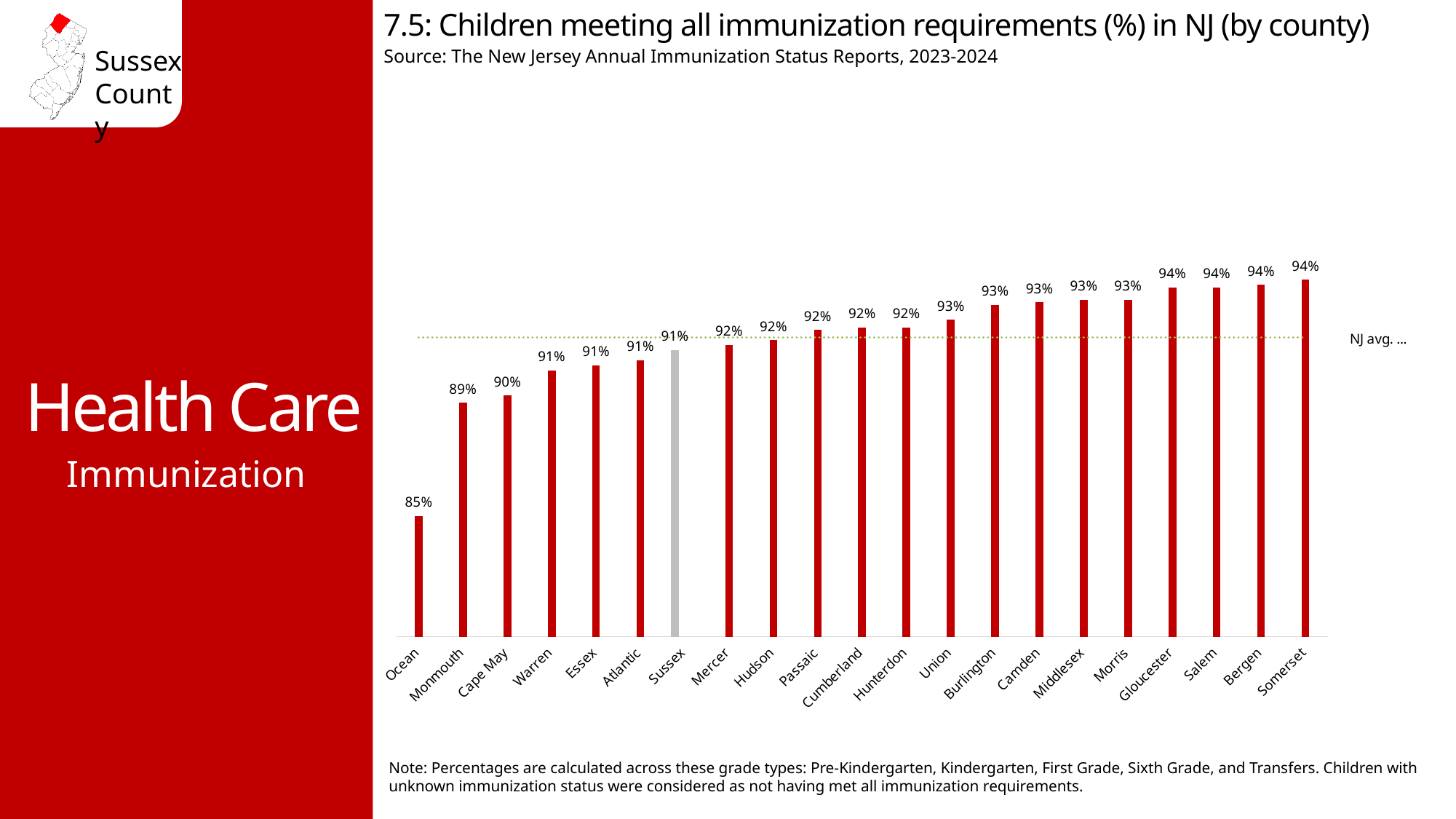
What is the difference between the values for Somerset and Ocean? 9 percentage points What is the value for Ocean? 85% What is the value for Hunterdon? 92% What is the value for Monmouth? 89% Do the values rise or fall from left to right along the x axis? rise What type of chart is shown on the slide? bar chart Which is larger, the value for Cape May or the value for Union? Union What is the value for Sussex? 91% What is the value for Somerset? 94% Which county has the lowest percentage of children meeting all immunization requirements? Ocean How many counties are shown in the chart? 21 What is the difference between the values for Sussex and Monmouth? 2 percentage points